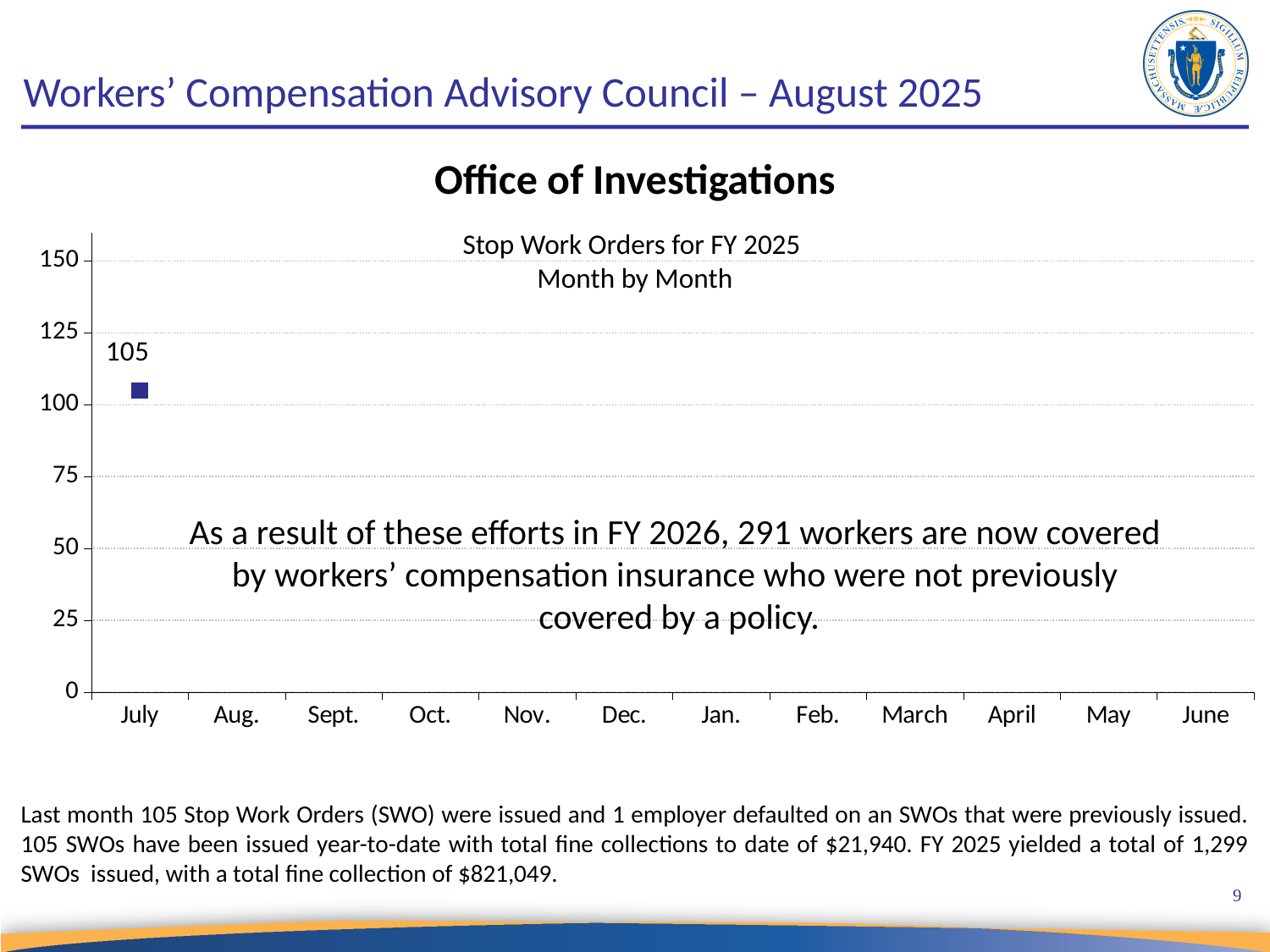
Which month is the first category on the x axis? July Which month has a value plotted on the chart? July Is the value for July greater or less than 100? greater Which month is the last category on the x axis? June What is the value plotted for July in the Stop Work Orders for FY 2025 Month by Month chart? 105 What is the highest value shown on the y axis of the chart? 150 What is the title of the chart? Stop Work Orders for FY 2025 Month by Month How many data points are plotted on the chart? 1 How many months are labelled along the x axis of the chart? 12 Is the value for July greater or less than 125? less